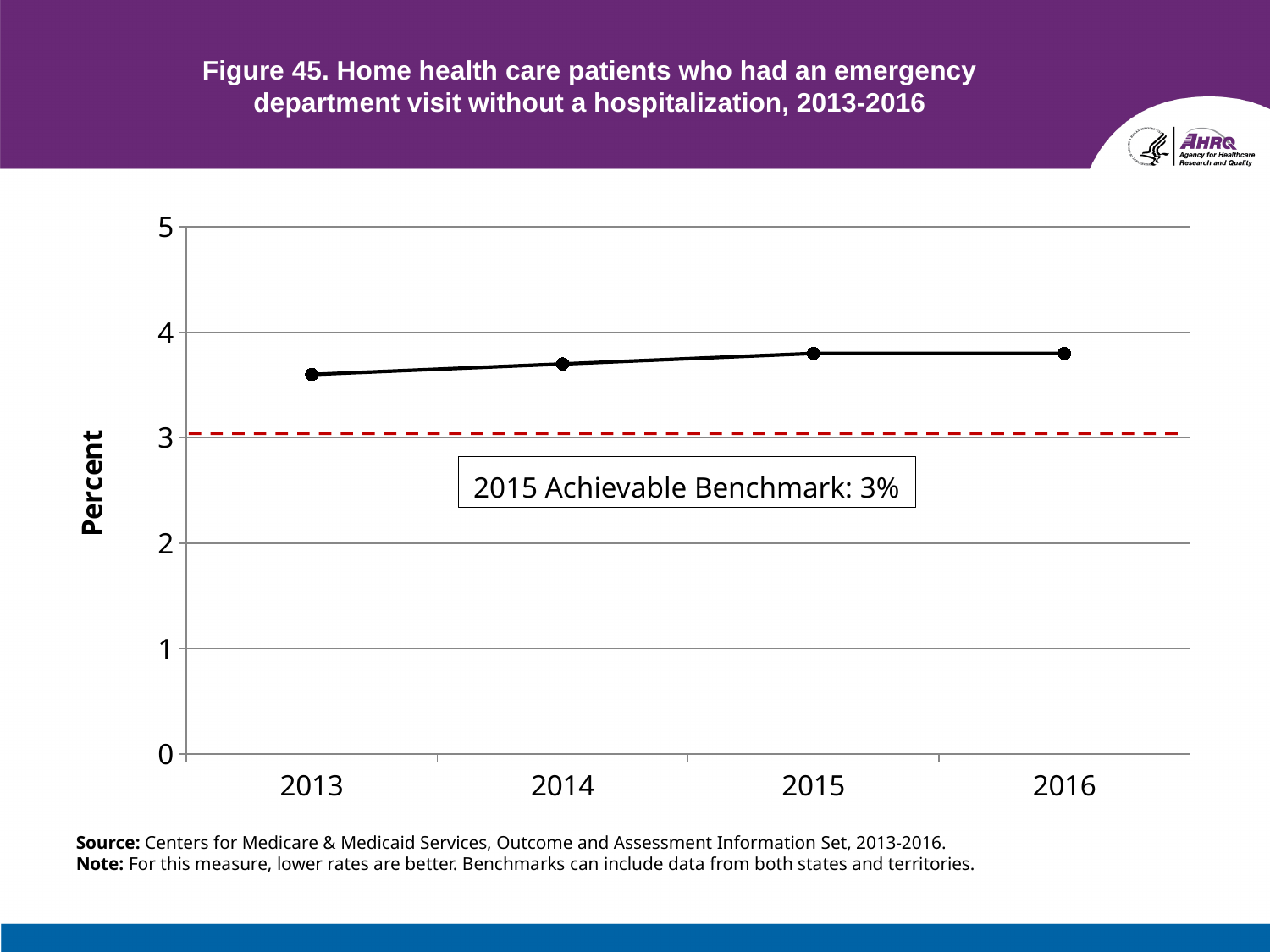
Do the plotted values rise or fall from 2013 to 2016? rise Is the value for 2016 greater or less than 4? less What kind of chart is shown on the slide? line chart What is the 2015 Achievable Benchmark shown on the chart? 3% Which is larger, the value for 2013 or the value for 2015? 2015 What is the highest value shown on the y axis? 5 What is the label of the y axis? Percent Which is larger, the value for 2014 or the value for 2016? 2016 How many years are plotted on the x axis? 4 Is the value for 2015 greater or less than 3? greater Which year has the lowest plotted value? 2013 Is the value for 2013 greater or less than 3? greater